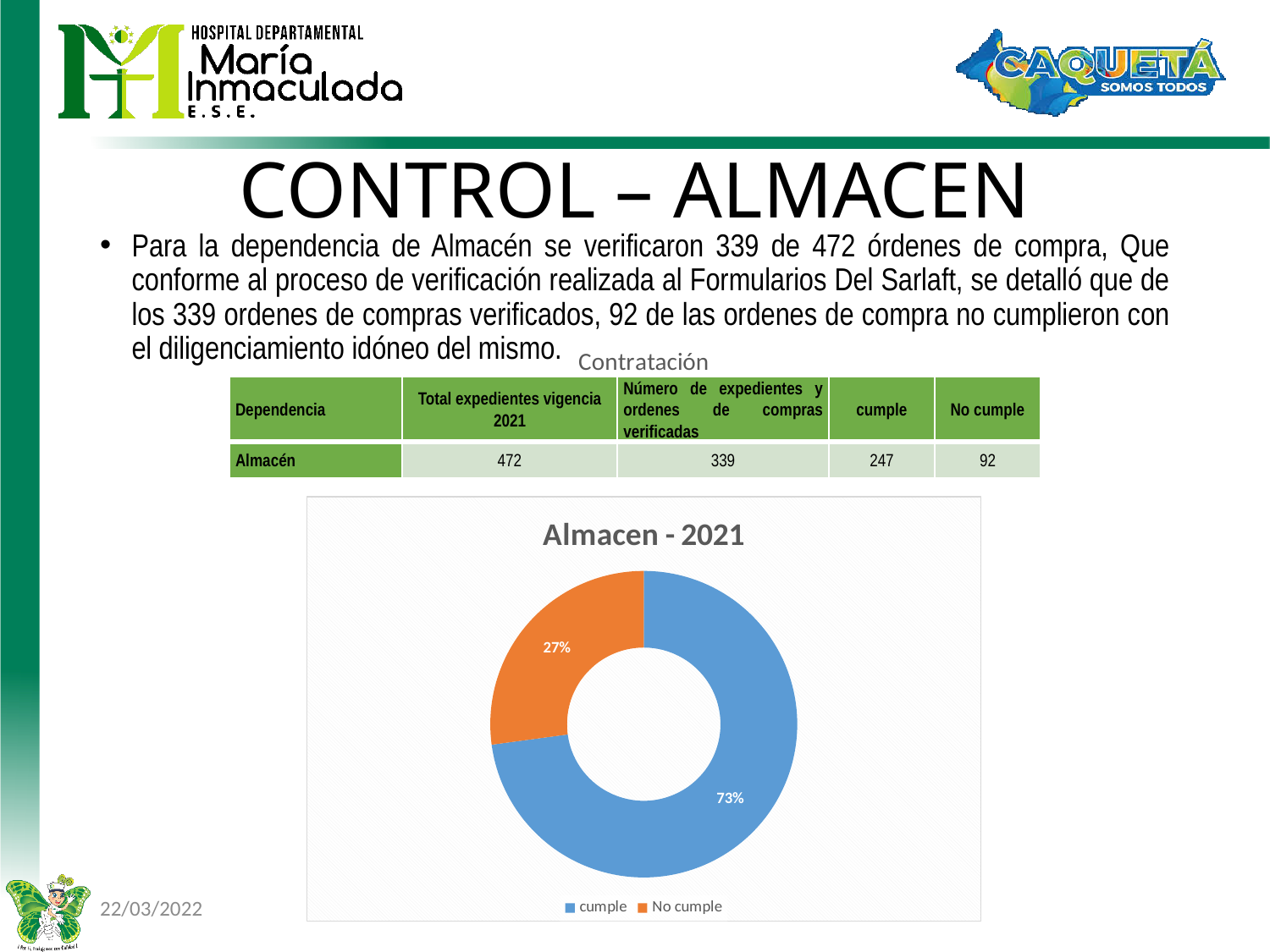
What colour is the 'No cumple' slice in the Almacen - 2021 chart? orange In the Almacen - 2021 chart, is the 'cumple' share larger or smaller than the 'No cumple' share? larger Which slice is the largest in the Almacen - 2021 chart? cumple What is the difference in percentage points between the 'cumple' and 'No cumple' slices in the Almacen - 2021 chart? 46 percentage points What is the title of the chart on the slide? Almacen - 2021 How many entries does the legend of the Almacen - 2021 chart list? 2 How many slices does the Almacen - 2021 chart have? 2 Which slice is the smallest in the Almacen - 2021 chart? No cumple What percentage does the 'No cumple' slice show in the Almacen - 2021 chart? 27% What percentage does the 'cumple' slice show in the Almacen - 2021 chart? 73% What kind of chart is shown on the slide? doughnut chart